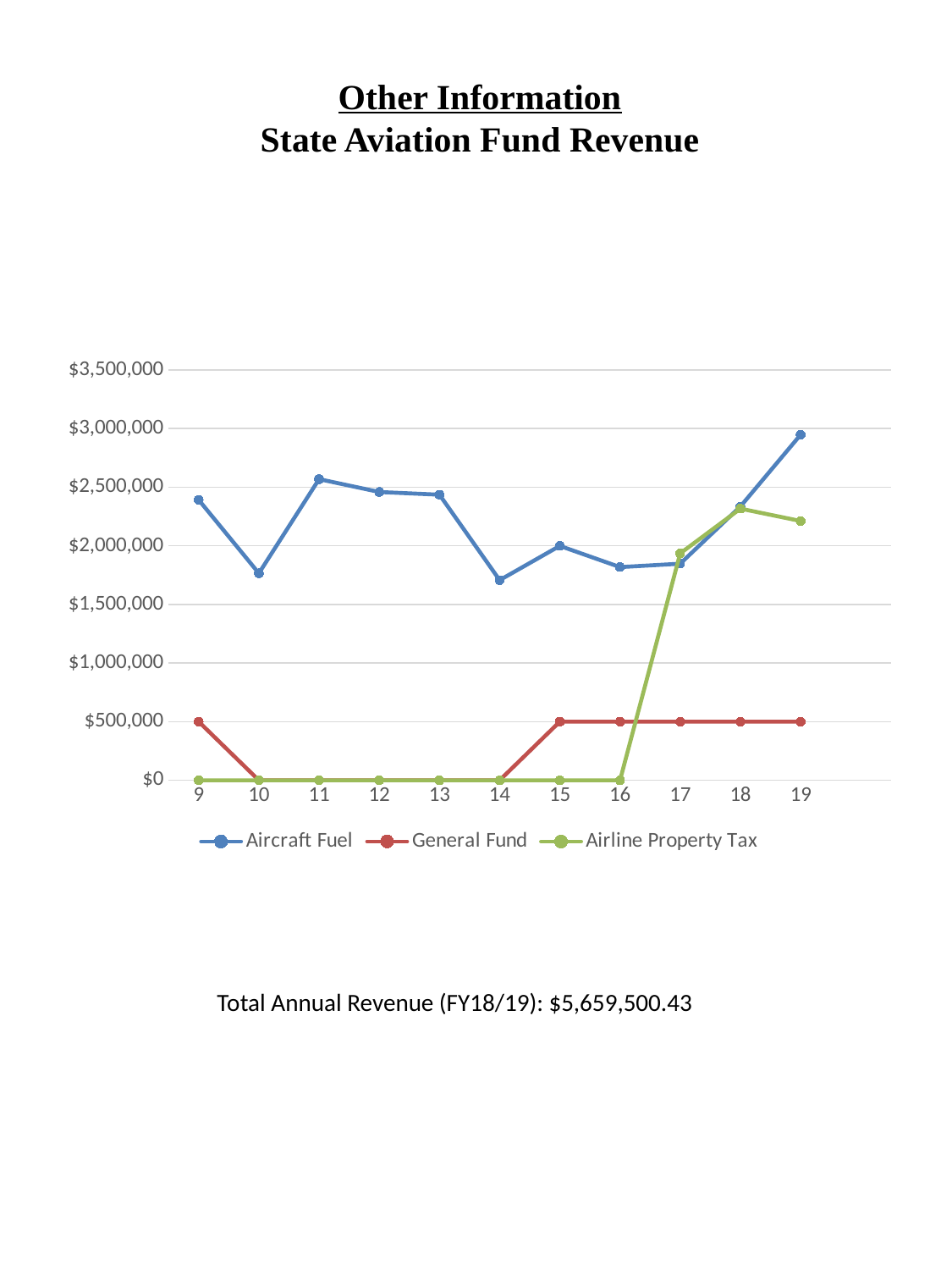
Is the Aircraft Fuel value at year 14 greater or less than $2,000,000? less What is the General Fund value at year 10? $0 What is the Airline Property Tax value at year 12? $0 At year 19, which is larger: Aircraft Fuel or Airline Property Tax? Aircraft Fuel What is the difference between the General Fund value at year 15 and at year 14? $500,000 Is the Aircraft Fuel value at year 19 greater or less than $2,500,000? greater Does the Airline Property Tax value rise or fall from year 16 to year 17? rise In which year is the Aircraft Fuel value highest? 19 How many series does the legend list? 3 What is the General Fund value at year 15? $500,000 How many points along the x axis does each series have? 11 What kind of chart is shown on the slide? line chart